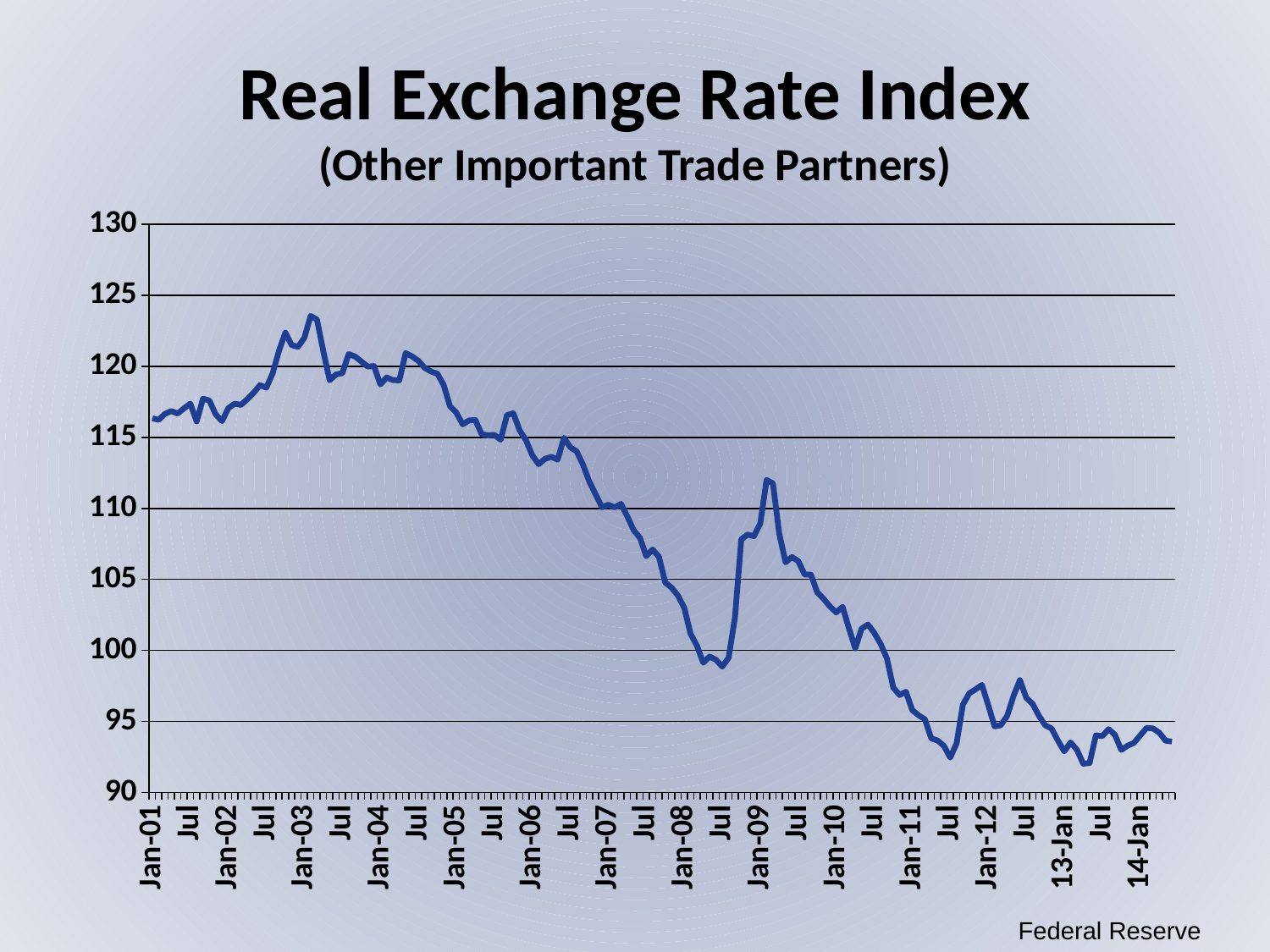
Is the value for Jan-03 greater or less than 120? greater What is the title of the chart? Real Exchange Rate Index (Other Important Trade Partners) Does the index rise or fall between Jul-08 and Jan-09? rise Which is larger, the value for Jan-01 or the value for Jan-12? Jan-01 What kind of chart is shown on the slide? line chart What source is cited for the chart data? Federal Reserve Overall, does the Real Exchange Rate Index rise or fall from Jan-01 to 14-Jan? fall Does the index rise or fall between Jan-08 and Jul-08? fall Is the value for Jan-01 greater or less than 110? greater Is the value for Jan-11 greater or less than 100? less In which year does the index reach its highest point? 2003